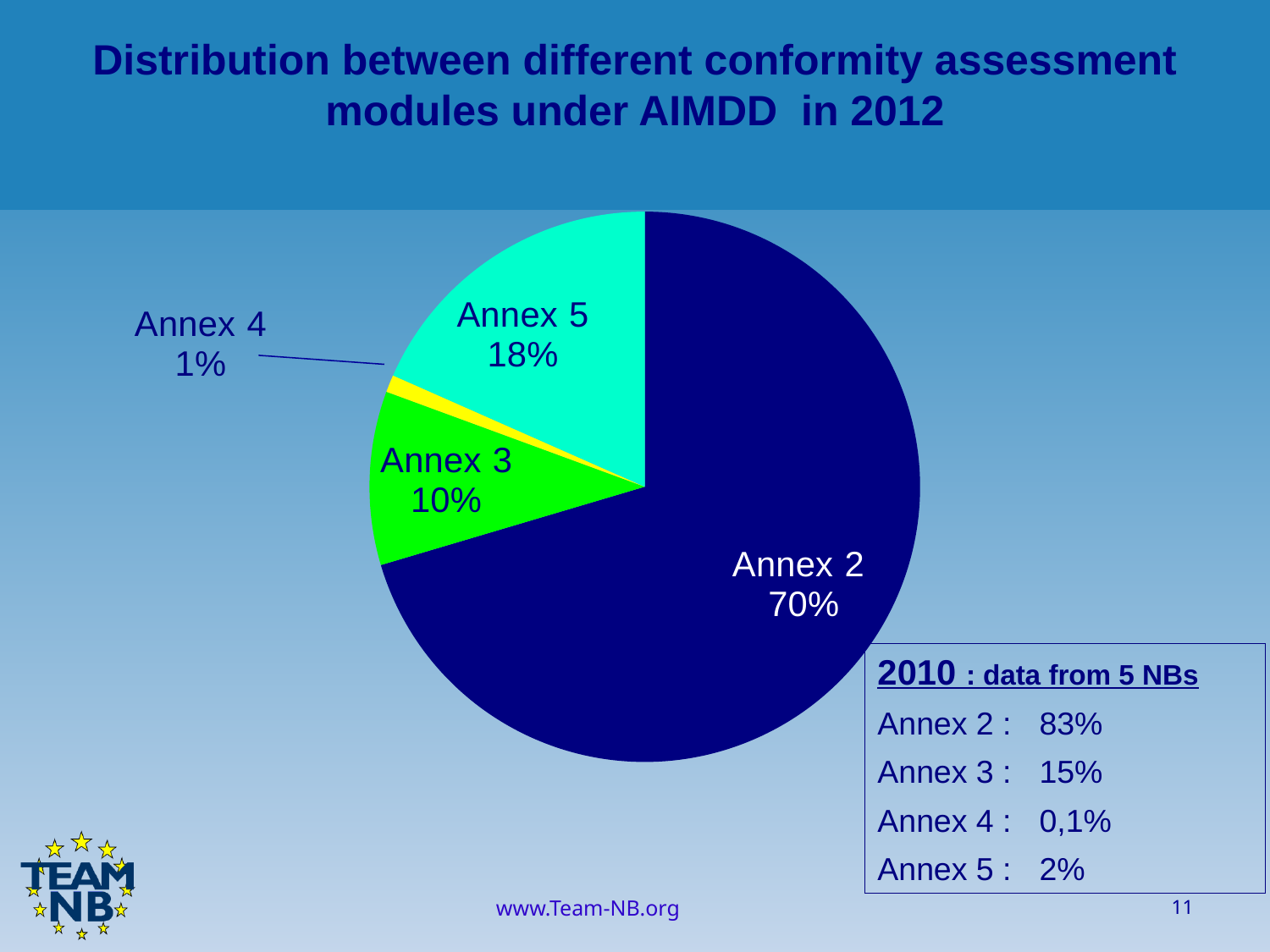
What is the title of the chart on the slide? Distribution between different conformity assessment modules under AIMDD in 2012 What type of chart is shown on the slide? pie chart Which is larger, the slice for Annex 3 or the slice for Annex 5? Annex 5 What is the value shown for Annex 3? 10% What colour is the Annex 2 slice of the pie? dark blue What share of the pie does Annex 2 have? 70% What is the value shown for Annex 4? 1% How many slices does the pie chart have? 4 Which annex has the smallest slice of the pie? Annex 4 What is the difference in percentage points between Annex 2 and Annex 5? 52 Which annex has the largest slice of the pie? Annex 2 What is the value shown for Annex 5? 18%